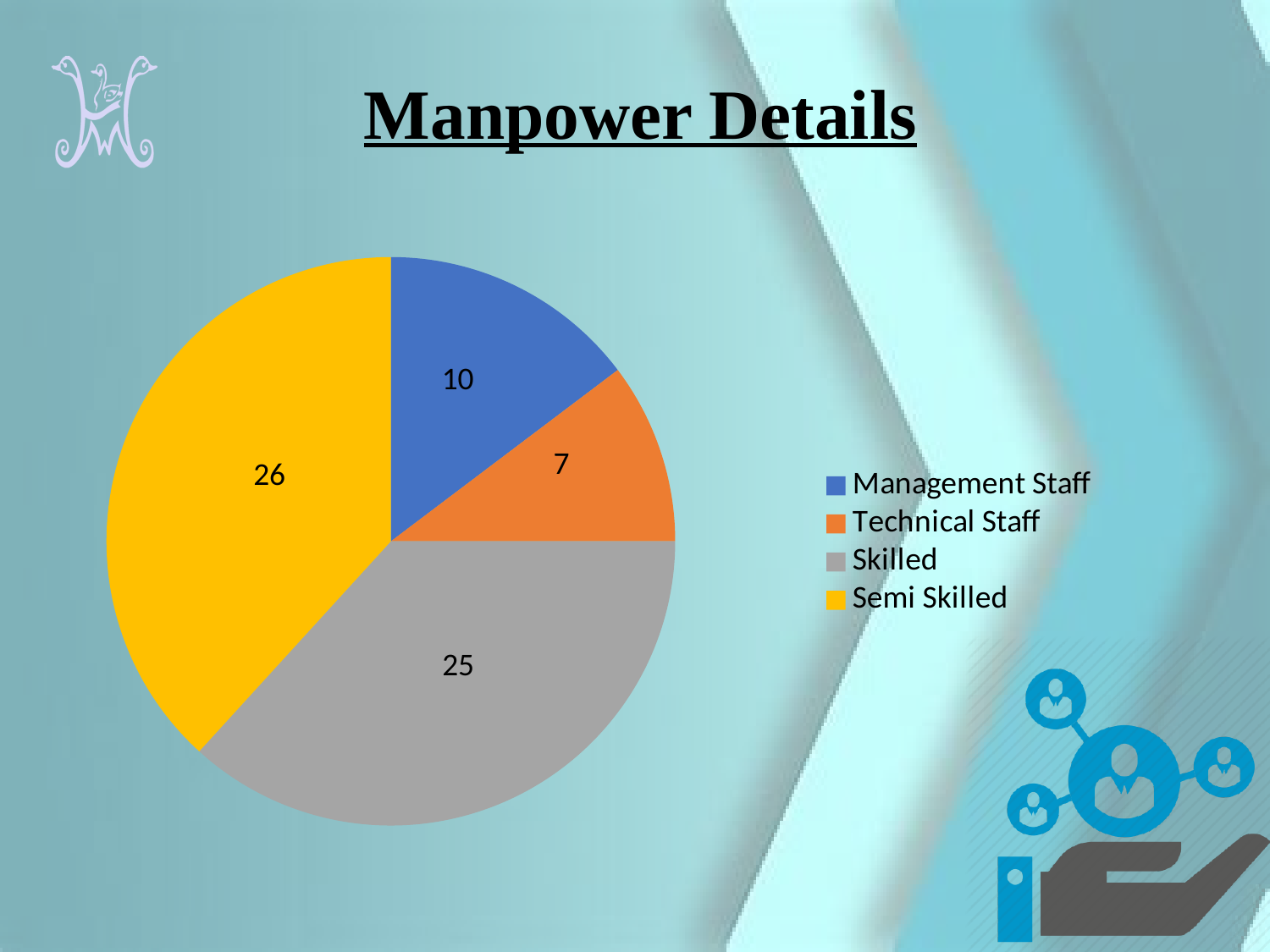
Which is larger, Management Staff or Technical Staff? Management Staff What is the value for Skilled? 25 What is the total of all slices in the pie chart? 68 What type of chart is shown on the slide? Pie chart What is the difference between the Skilled and Management Staff values? 15 How many categories does the pie chart have? 4 What is the value for Semi Skilled? 26 What is the value for Technical Staff? 7 What is the value for Management Staff? 10 Which category has the smallest slice? Technical Staff What is the title of the slide containing the chart? Manpower Details Which category has the largest slice? Semi Skilled